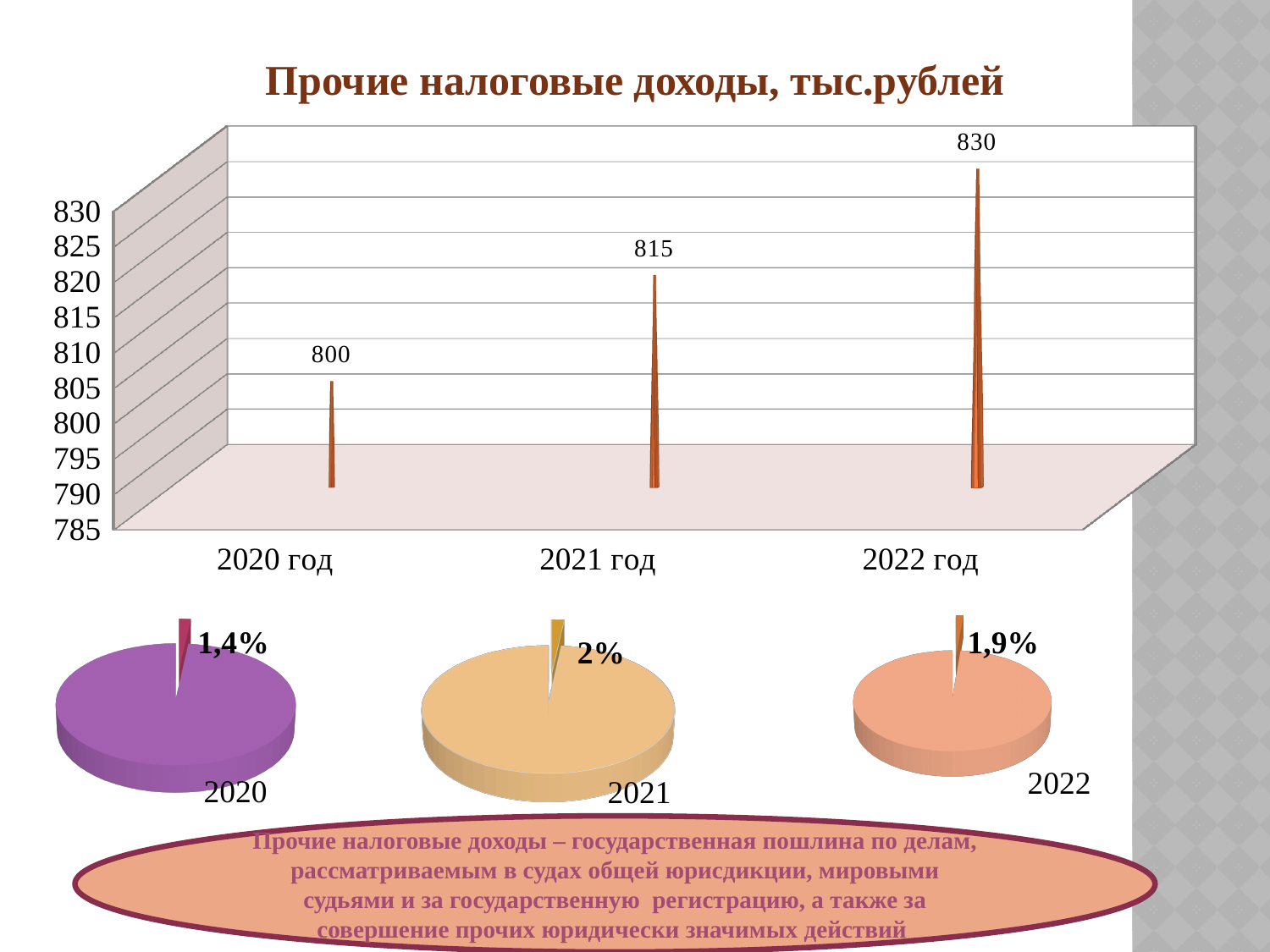
What kind of chart is the top chart titled 'Прочие налоговые доходы, тыс.рублей'? bar chart In the pie chart labelled 2020 at the bottom left, what share is shown for the small slice? 1,4% In the bar chart 'Прочие налоговые доходы, тыс.рублей', which year has the lowest value? 2020 год In the bar chart 'Прочие налоговые доходы, тыс.рублей', what is the value for 2020 год? 800 In the bar chart 'Прочие налоговые доходы, тыс.рублей', which is larger: the value for 2021 год or 2020 год? 2021 год In the bar chart 'Прочие налоговые доходы, тыс.рублей', what is the value for 2022 год? 830 In the pie chart labelled 2022 at the bottom right, what share is shown for the small slice? 1,9% In the bar chart 'Прочие налоговые доходы, тыс.рублей', what is the difference between the values for 2022 год and 2020 год? 30 In the bar chart 'Прочие налоговые доходы, тыс.рублей', what is the value for 2021 год? 815 In the bar chart 'Прочие налоговые доходы, тыс.рублей', how many years are plotted? 3 In the bar chart 'Прочие налоговые доходы, тыс.рублей', which year has the highest value? 2022 год In the bar chart 'Прочие налоговые доходы, тыс.рублей', do the values rise or fall from 2020 год to 2022 год? rise